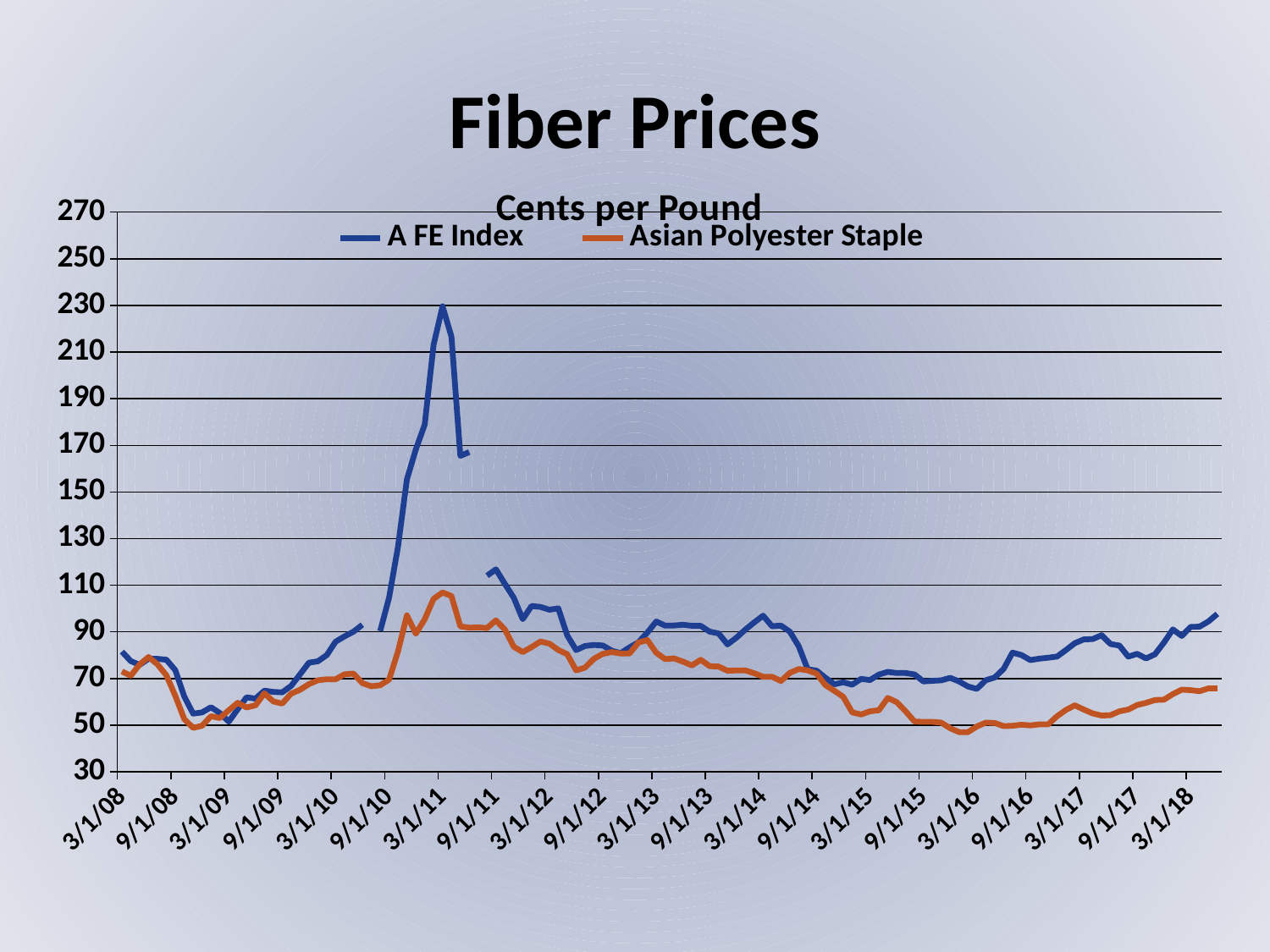
Is the value of Asian Polyester Staple around 3/1/16 greater or less than 50? less Which series reaches the highest value on the chart? A FE Index Which colour is used for the A FE Index line? Blue Does the Asian Polyester Staple line rise or fall between 3/1/16 and 3/1/18? Rise How many series does the legend list? 2 What unit is given for the values in the chart? Cents per Pound Is the peak value of the A FE Index around 3/1/11 greater or less than 210? greater At 3/1/17, which series has the higher value, A FE Index or Asian Polyester Staple? A FE Index Is the value of the A FE Index at 3/1/08 greater or less than 70? greater How many date labels are shown on the x axis? 21 What kind of chart is shown on the slide? Line chart Which series reaches the lowest value on the chart? Asian Polyester Staple